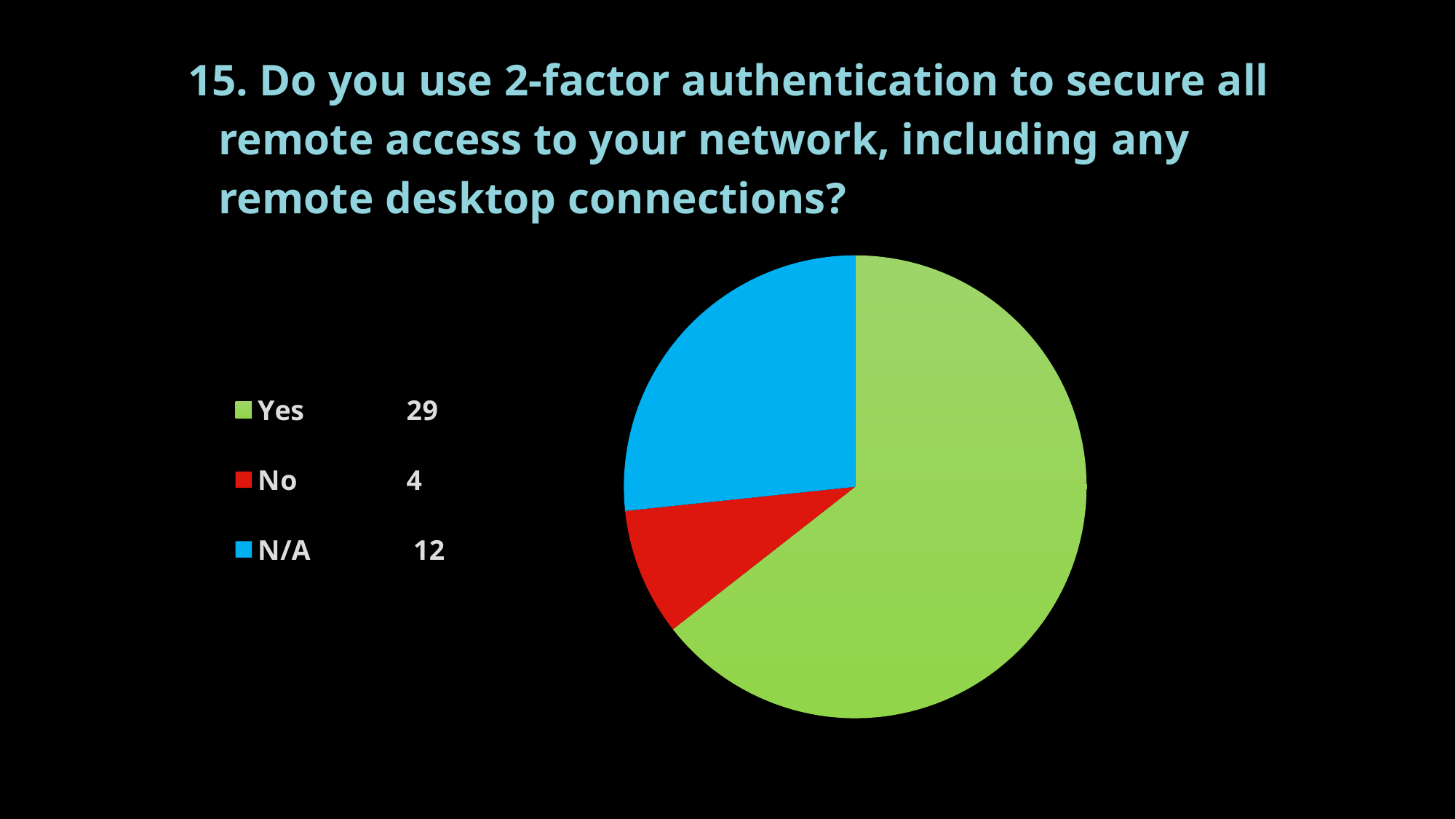
What is the difference between the number of "Yes" responses and the number of "N/A" responses? 17 Which response category has the largest slice of the pie? Yes Which has more responses, "No" or "N/A"? N/A How many responses are recorded for "Yes"? 29 What kind of chart is shown on the slide? pie chart What is the total number of responses across all three categories? 45 How many responses are recorded for "No"? 4 How many response categories does the pie chart show? 3 Which response category has the smallest slice of the pie? No What colour is the slice for "No"? red What is the difference between the number of "N/A" responses and the number of "No" responses? 8 How many responses are recorded for "N/A"? 12